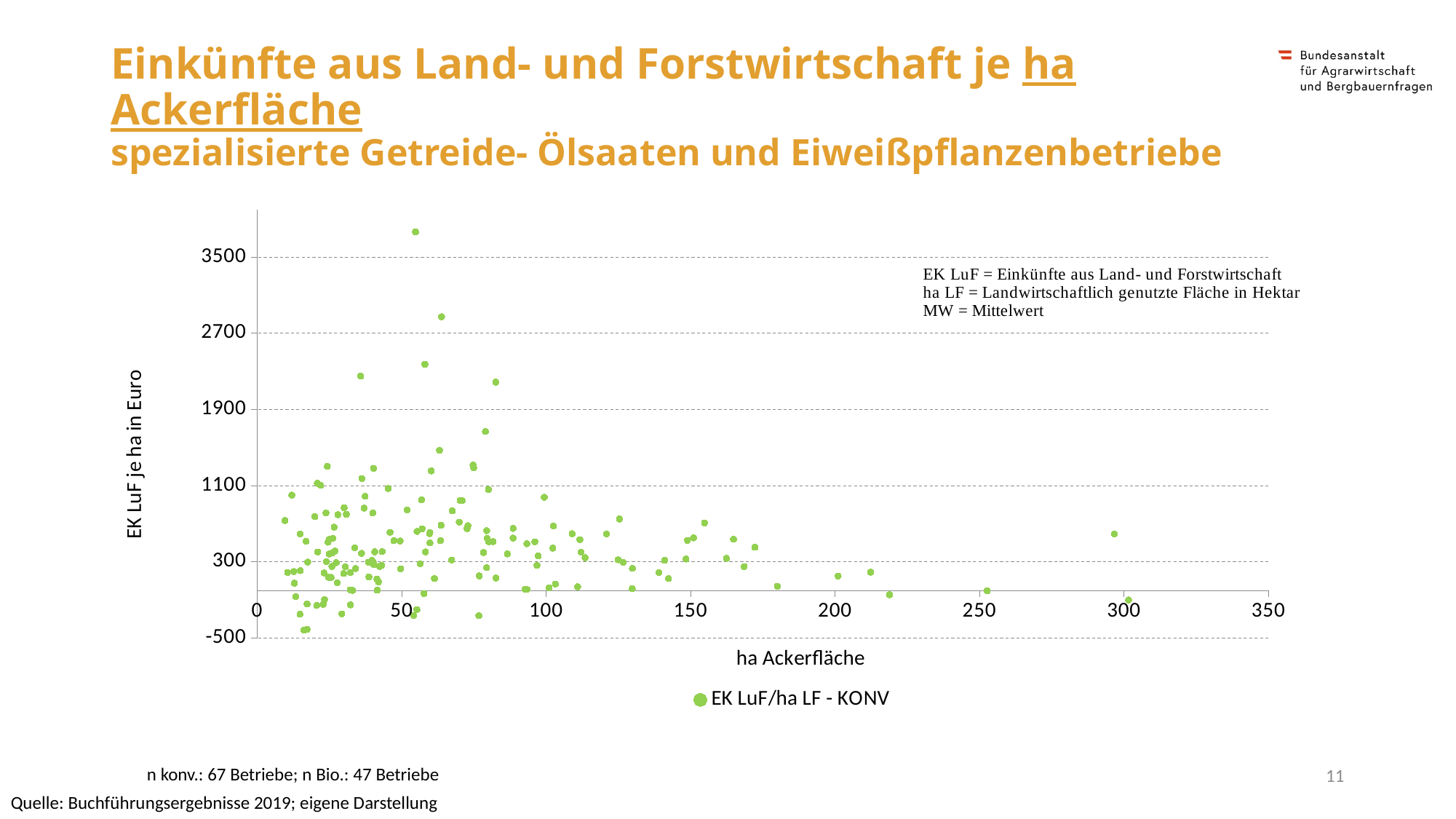
Do the values generally become lower and less spread out as ha Ackerfläche increases along the x axis? yes Is the value of the highest point on the chart greater or less than 3500? greater Is the value of the point at roughly 300 ha Ackerfläche greater or less than 1100? less Is the value of the point at roughly 250 ha Ackerfläche greater or less than 300? less What is the name of the series shown in the legend? EK LuF/ha LF - KONV What is the title of the x axis? ha Ackerfläche What kind of chart is shown on the slide? scatter chart How many series does the legend list? 1